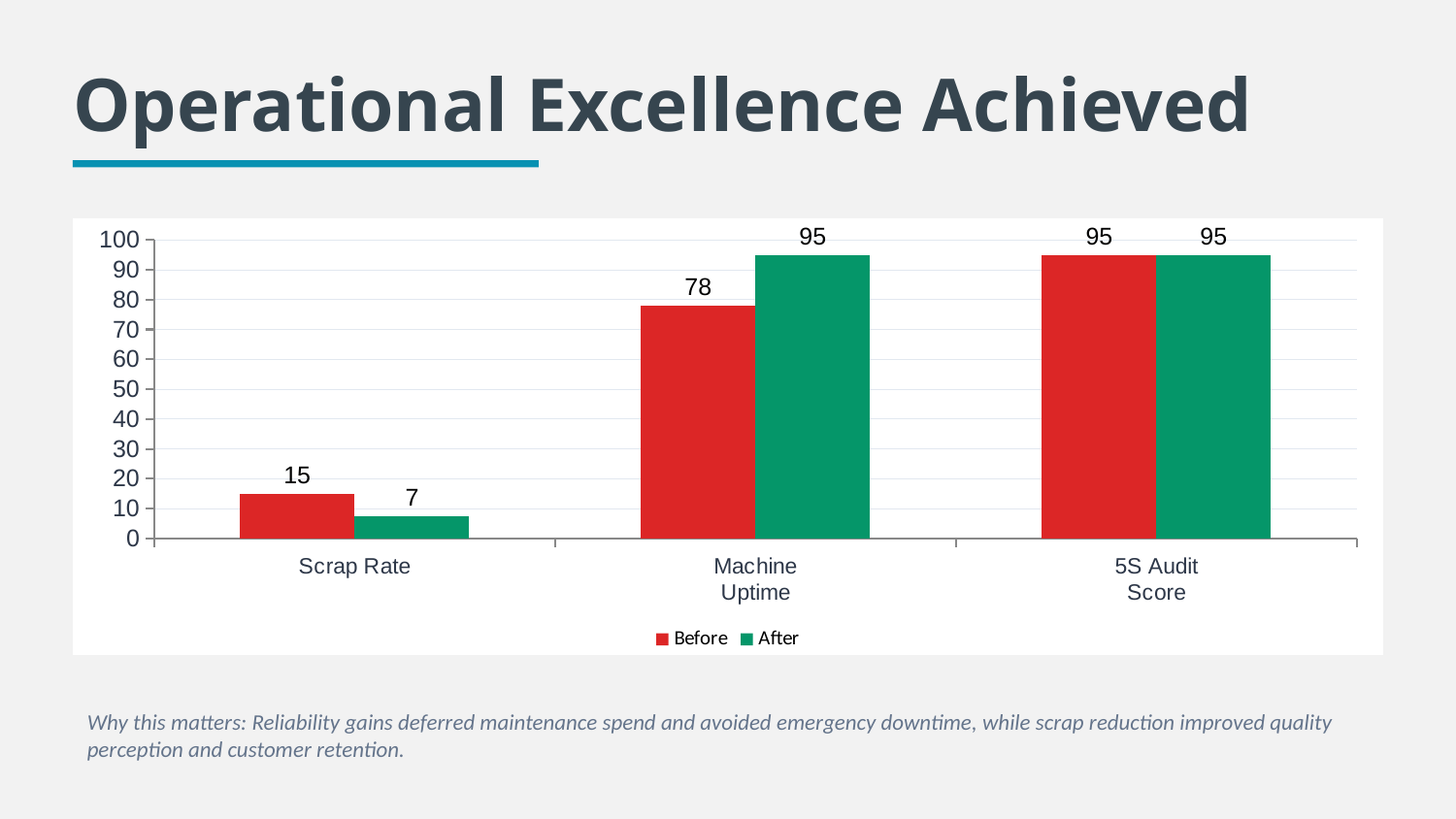
What is the Before value for Scrap Rate? 15 Which category has the highest Before value? 5S Audit Score What is the difference between the After and Before values for Machine Uptime? 17 What kind of chart is shown on the slide? Bar chart What is the Before value for 5S Audit Score? 95 What is the After value for Scrap Rate? 7 Which is larger for Machine Uptime, the Before value or the After value? After How many series does the legend list? 2 How many categories are shown on the x axis? 3 What is the After value for Machine Uptime? 95 Which category has the lowest After value? Scrap Rate What is the difference between the Before and After values for Scrap Rate? 8